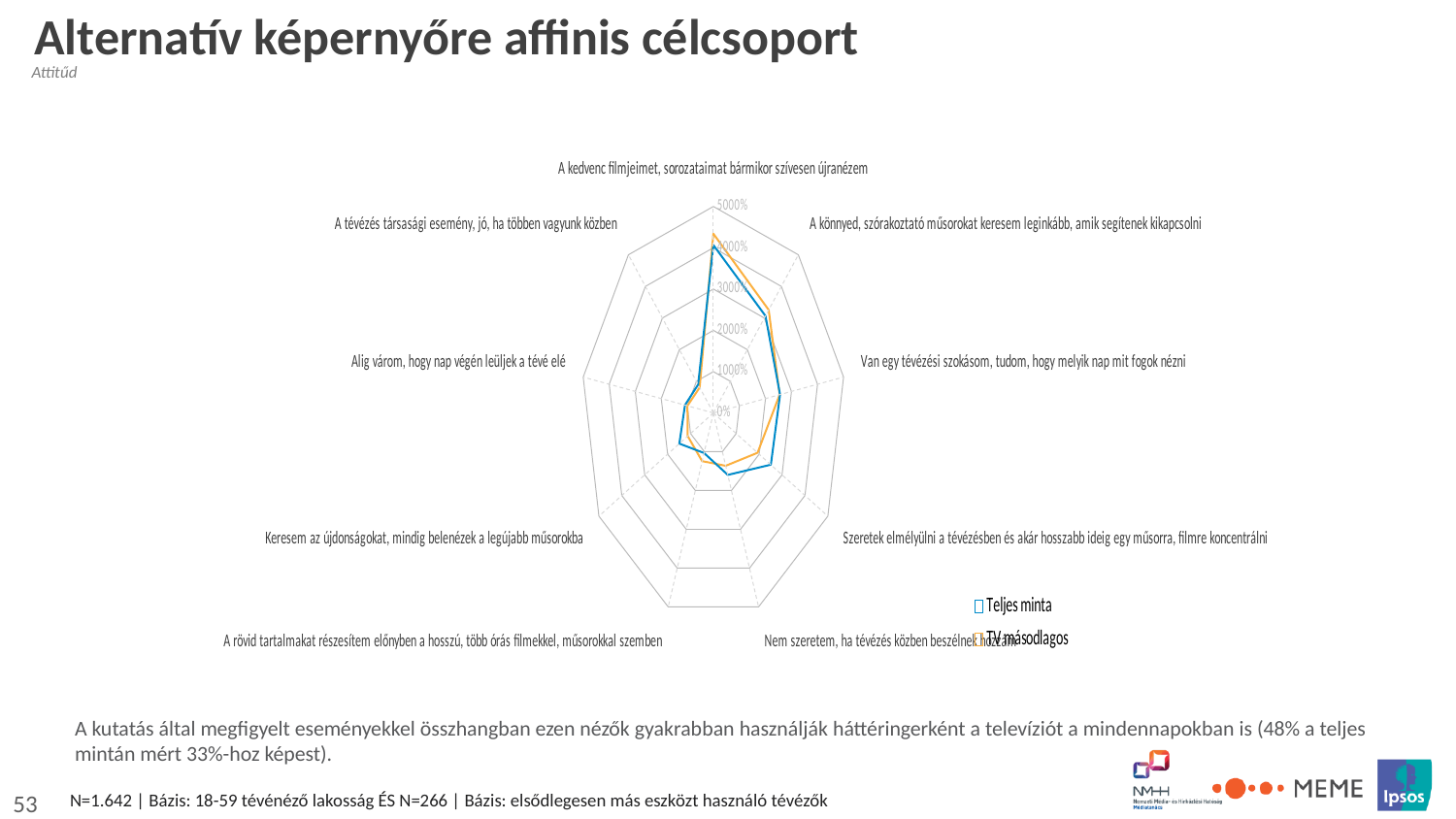
What is the highest axis tick shown on the radar chart? 5000% What is the title of the slide containing the radar chart? Alternatív képernyőre affinis célcsoport Is the value for 'Szeretek elmélyülni a tévézésben és akár hosszabb ideig egy műsorra, filmre koncentrálni' in the Teljes minta series greater or less than 3000%? less Is the value for 'A kedvenc filmjeimet, sorozataimat bármikor szívesen újranézem' in the Teljes minta series greater or less than 3000%? greater How many series does the legend list? 2 What are the two series named in the legend? Teljes minta and TV másodlagos How many categories (spokes) does the radar chart have? 9 Which category has the highest value in the Teljes minta series? A kedvenc filmjeimet, sorozataimat bármikor szívesen újranézem What kind of chart is shown on the slide? Radar chart